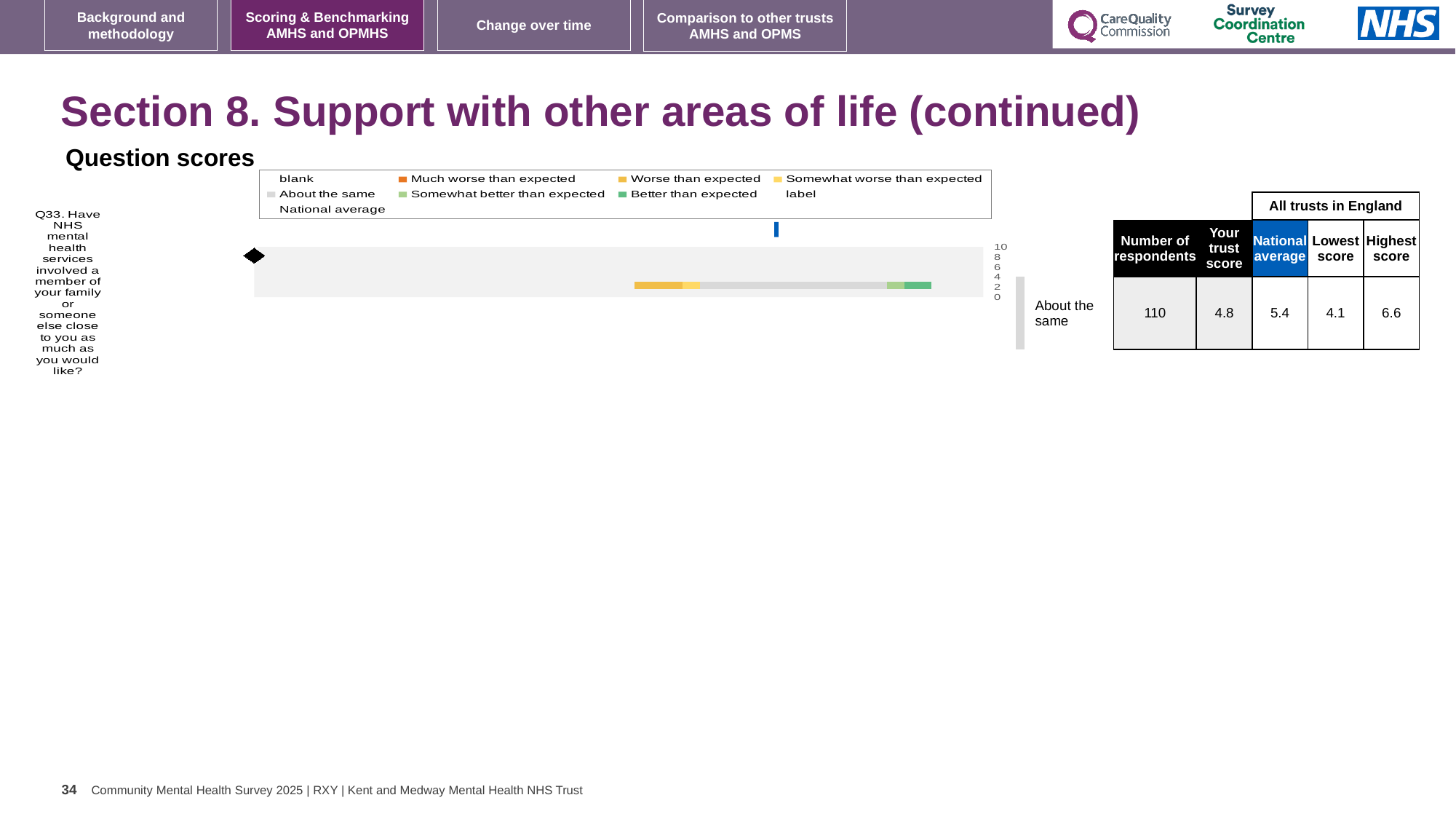
What is the difference between the Highest score and the Lowest score for Q33? 2.5 How many survey questions are plotted in the Question scores chart? 1 Which question is plotted in the Question scores chart? Q33. Have NHS mental health services involved a member of your family or someone else close to you as much as you would like? Which benchmark category is the trust's score for Q33 placed in? About the same What is the Highest score among all trusts in England for Q33? 6.6 What is the National average score for Q33? 5.4 What is the difference between the National average and the trust score for Q33? 0.6 Which is larger for Q33, the trust score or the National average? National average What is the Lowest score among all trusts in England for Q33? 4.1 How many respondents answered Q33? 110 What kind of chart is shown under 'Question scores'? bar chart What is the 'Your trust score' value for Q33? 4.8